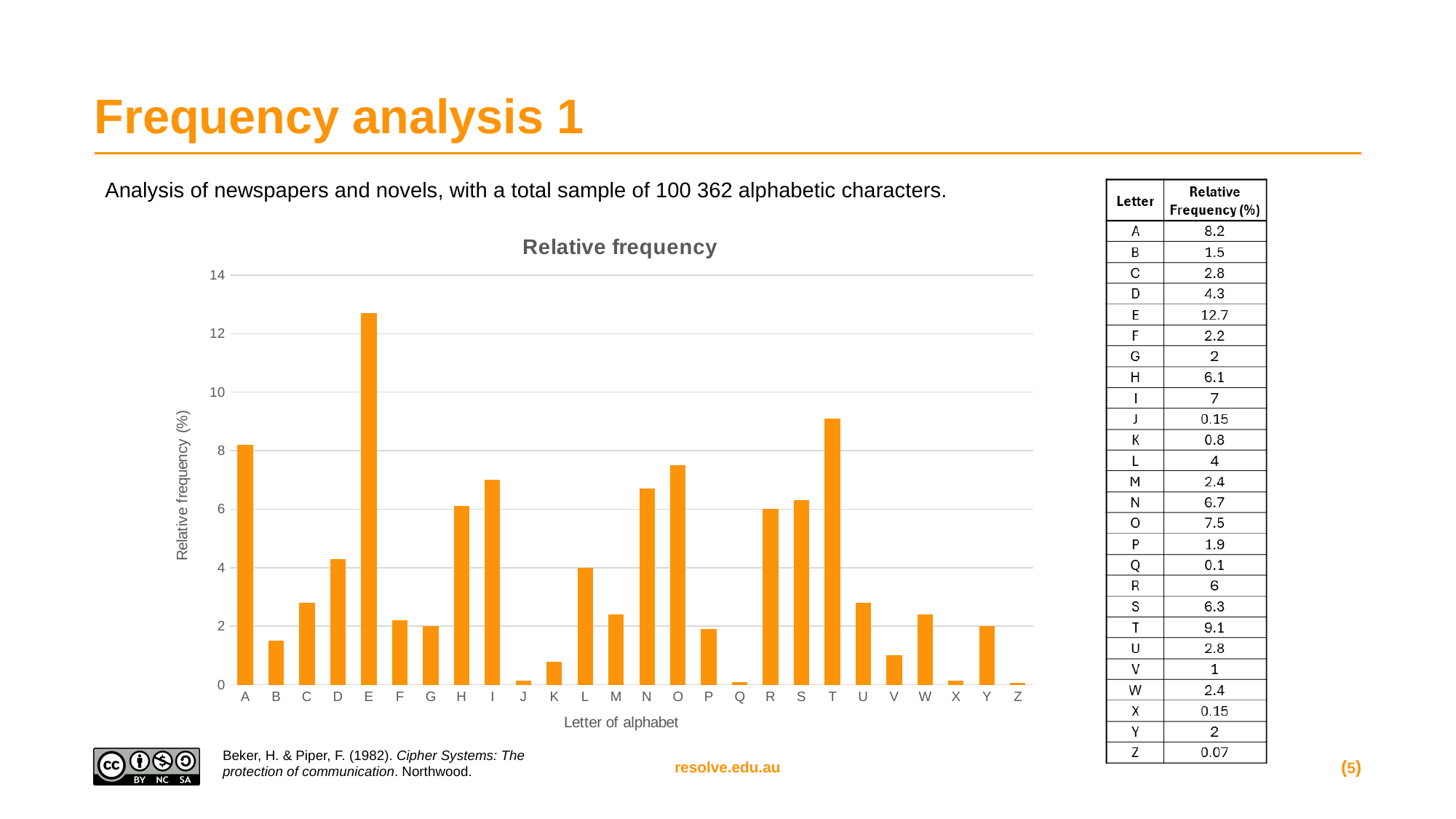
How many letters (categories) are plotted on the x axis of the chart? 26 What is the relative frequency (%) for the letter E? 12.7 What is the difference in relative frequency (%) between the letters E and T? 3.6 What type of chart is shown on the slide? bar chart Which has a higher relative frequency, the letter H or the letter I? I Which letter has the highest relative frequency in the chart? E Which has a higher relative frequency, the letter N or the letter O? O What is the label of the y axis of the chart? Relative frequency (%) What is the title of the chart? Relative frequency What is the relative frequency (%) for the letter T? 9.1 Is the relative frequency for the letter O greater or less than 8? less Is the relative frequency for the letter A greater or less than 8? greater